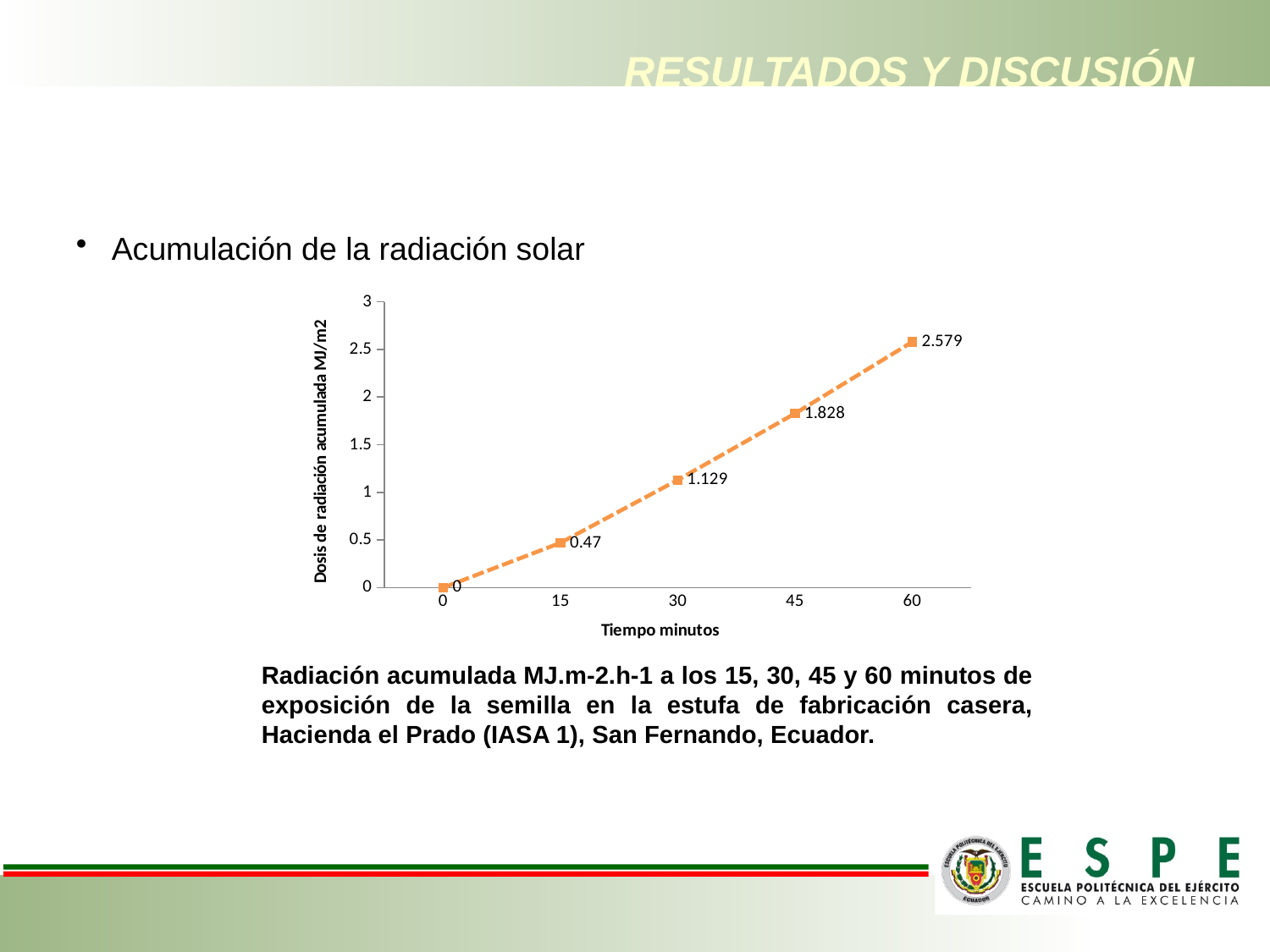
What is the accumulated radiation dose at 45 minutes? 1.828 What kind of chart is shown on the slide? line chart What is the accumulated radiation dose at 15 minutes? 0.47 How many data points are plotted on the chart? 5 What is the accumulated radiation dose at 60 minutes? 2.579 Do the values rise or fall as time increases along the x axis? rise What is the difference between the accumulated radiation dose at 60 minutes and at 45 minutes? 0.751 What is the accumulated radiation dose at 30 minutes? 1.129 Is the accumulated radiation dose at 45 minutes greater or less than 2? less At which time in minutes is the accumulated radiation dose lowest? 0 At which time in minutes is the accumulated radiation dose highest? 60 Which is larger, the accumulated radiation dose at 30 minutes or at 45 minutes? 45 minutes